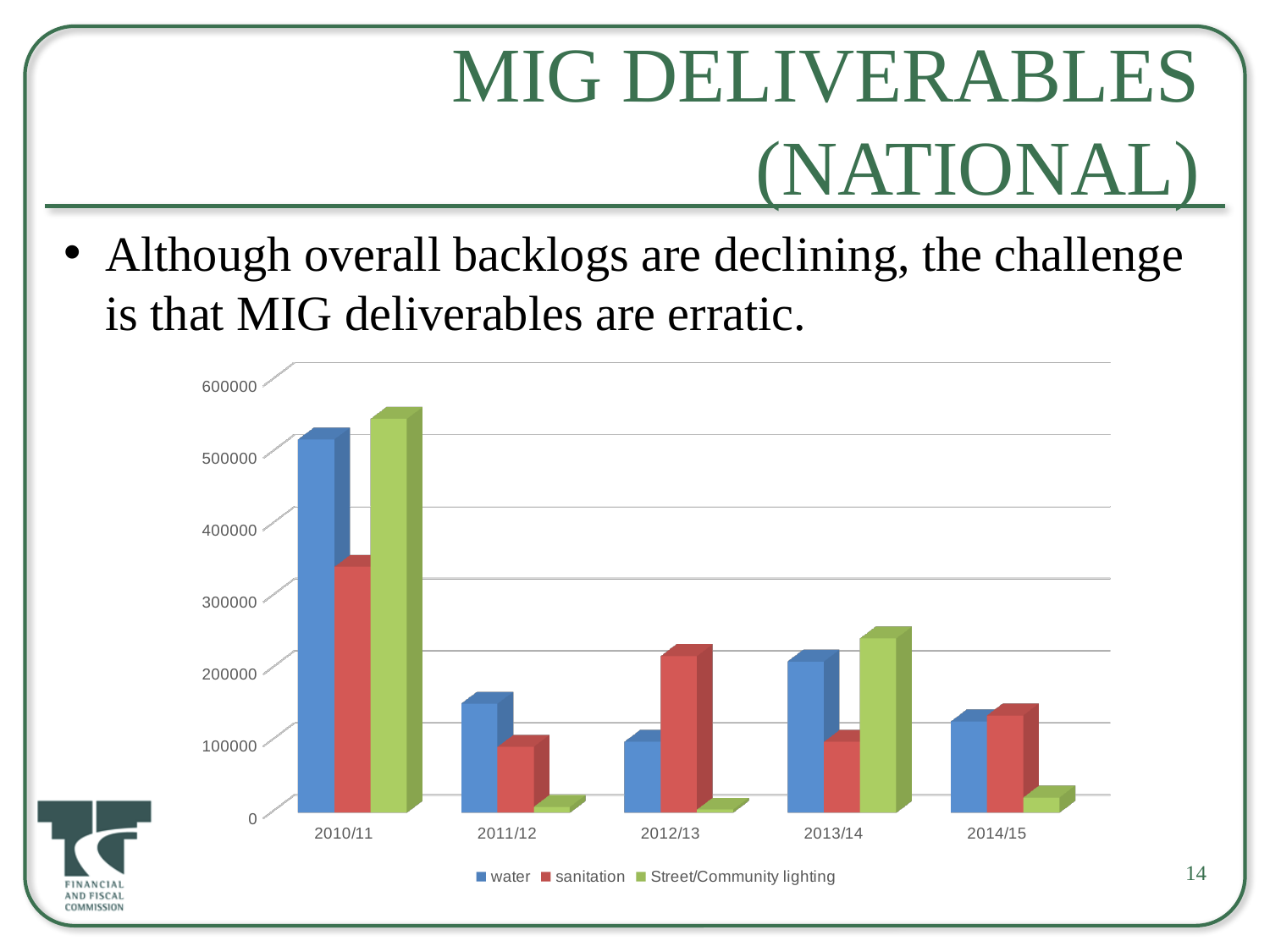
How many financial years are shown on the x axis of the chart? 5 In which year is the sanitation value highest? 2010/11 How many series does the chart legend list? 3 In which year is the water value lowest? 2012/13 In which year is the water value highest? 2010/11 Which series is shown in green in the chart legend? Street/Community lighting Is the sanitation value for 2011/12 greater or less than 100000? less In 2013/14, which is larger: sanitation or Street/Community lighting? Street/Community lighting In 2012/13, which is larger: water or sanitation? sanitation Is the Street/Community lighting value for 2013/14 greater or less than 200000? greater Is the water value for 2010/11 greater or less than 400000? greater What kind of chart is shown on the slide? bar chart